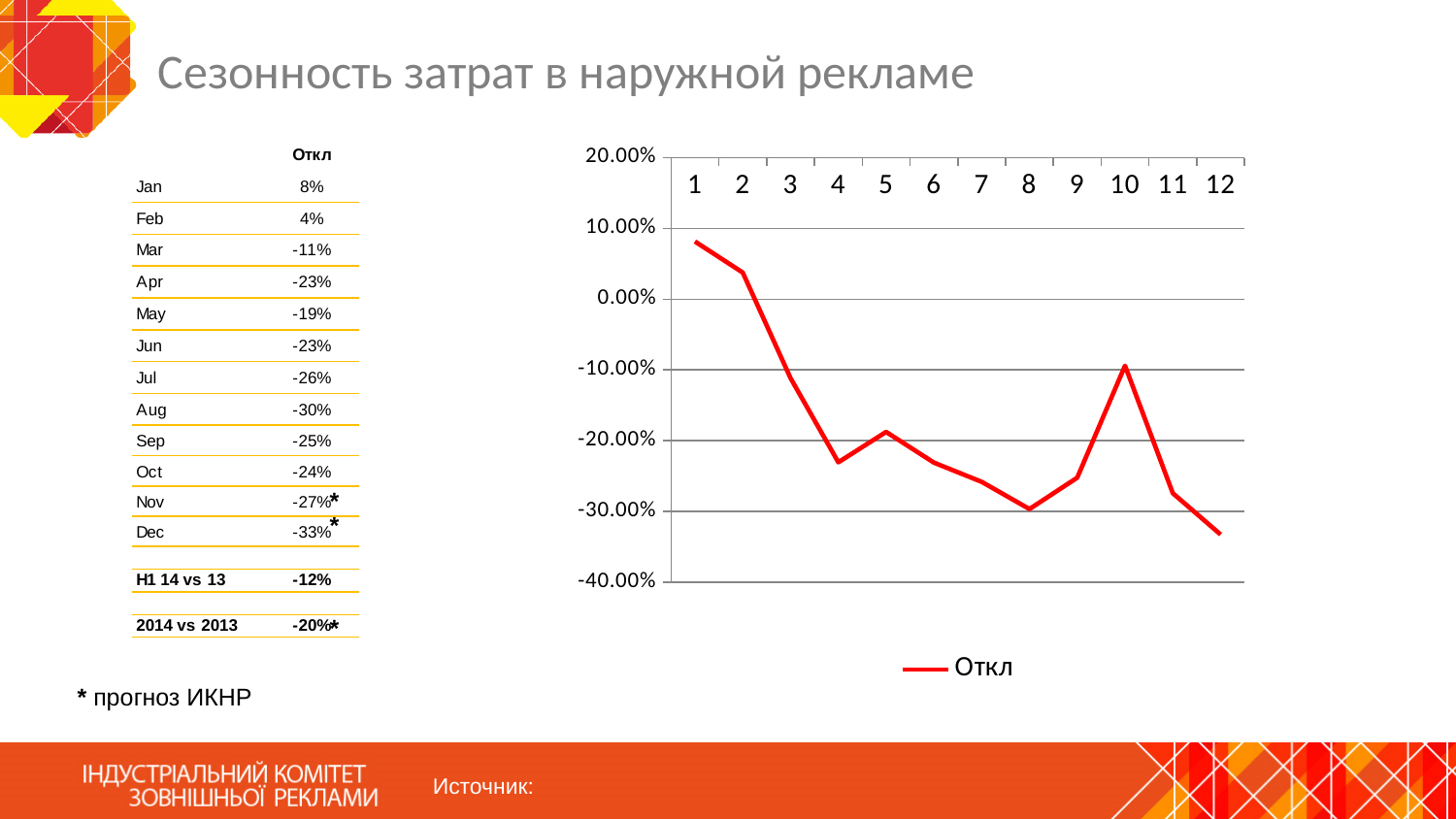
What kind of chart is shown on the slide? line chart How many series does the chart legend list? 1 Is the value at point 2 greater or less than 0.00%? greater According to the table on the slide, what is the Откл value for Aug? -30% Is the value at point 4 greater or less than -20.00%? less At which x-axis point is the value of the Откл line lowest? 12 Does the Откл line rise or fall from point 1 to point 4? fall At which x-axis point is the value of the Откл line highest? 1 What is the name of the series shown in the chart legend? Откл Which has the larger value, point 5 or point 4? point 5 How many points are plotted along the x axis of the chart? 12 Is the value at point 10 greater or less than -20.00%? greater